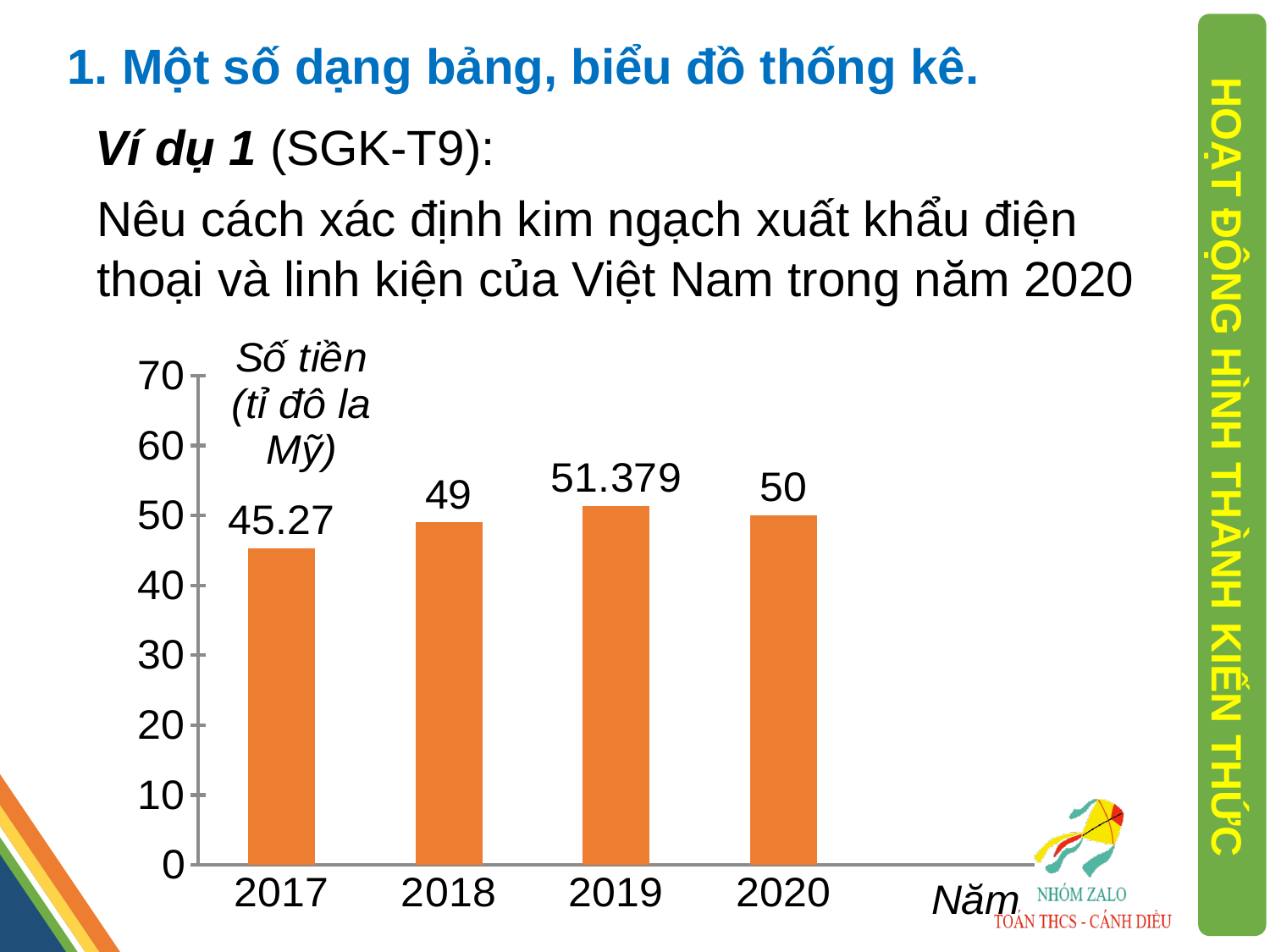
Which is larger, the value for 2018 or the value for 2020? 2020 What kind of chart is shown on the slide? bar chart What is the difference between the values for 2018 and 2017? 3.73 Is the value for 2017 greater or less than 40? greater What is the value for 2020? 50 How many years are shown on the x axis? 4 Which year has the lowest value? 2017 What is the value for 2017? 45.27 Which year has the highest value? 2019 What is the label of the vertical axis? Số tiền (tỉ đô la Mỹ) What is the value for 2019? 51.379 What is the difference between the values for 2019 and 2020? 1.379